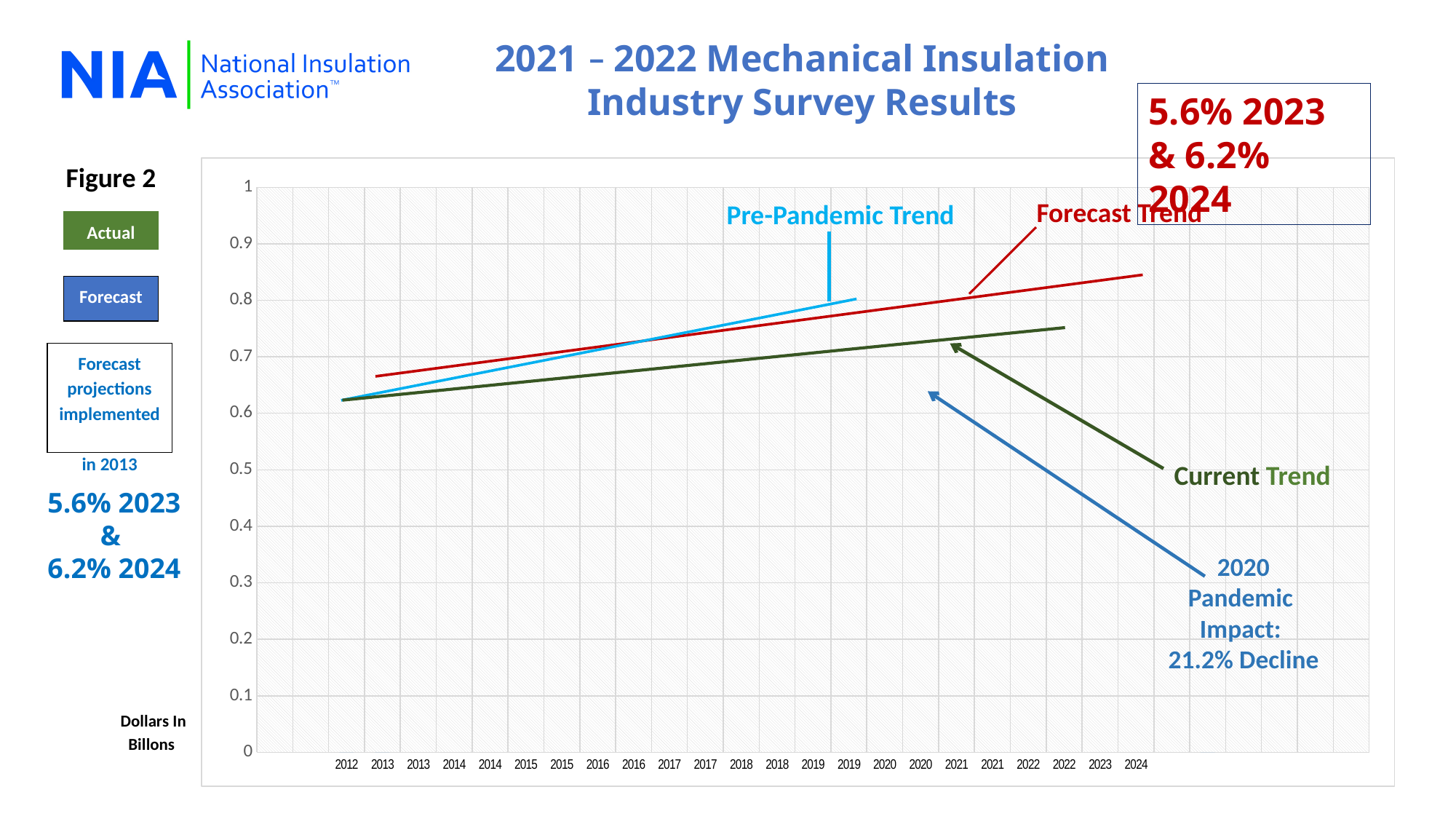
What percentage decline does the chart annotation attribute to the 2020 pandemic impact? 21.2% Decline Is the value of the Forecast Trend line at 2024 greater or less than 0.8? greater How many trend lines are plotted on the chart? 3 Does the Current Trend line rise or fall from 2012 to 2024? rise Is the value of the Current Trend line at 2012 greater or less than 0.7? less Does the Forecast Trend line rise or fall along the x axis? rise What kind of chart is shown on the slide? line chart What is the highest value shown on the y axis of the chart? 1 Is the value of the Current Trend line at 2024 greater or less than 0.7? greater At 2019, which line is higher: the Pre-Pandemic Trend or the Current Trend? Pre-Pandemic Trend At 2024, which line is higher: the Forecast Trend or the Current Trend? Forecast Trend